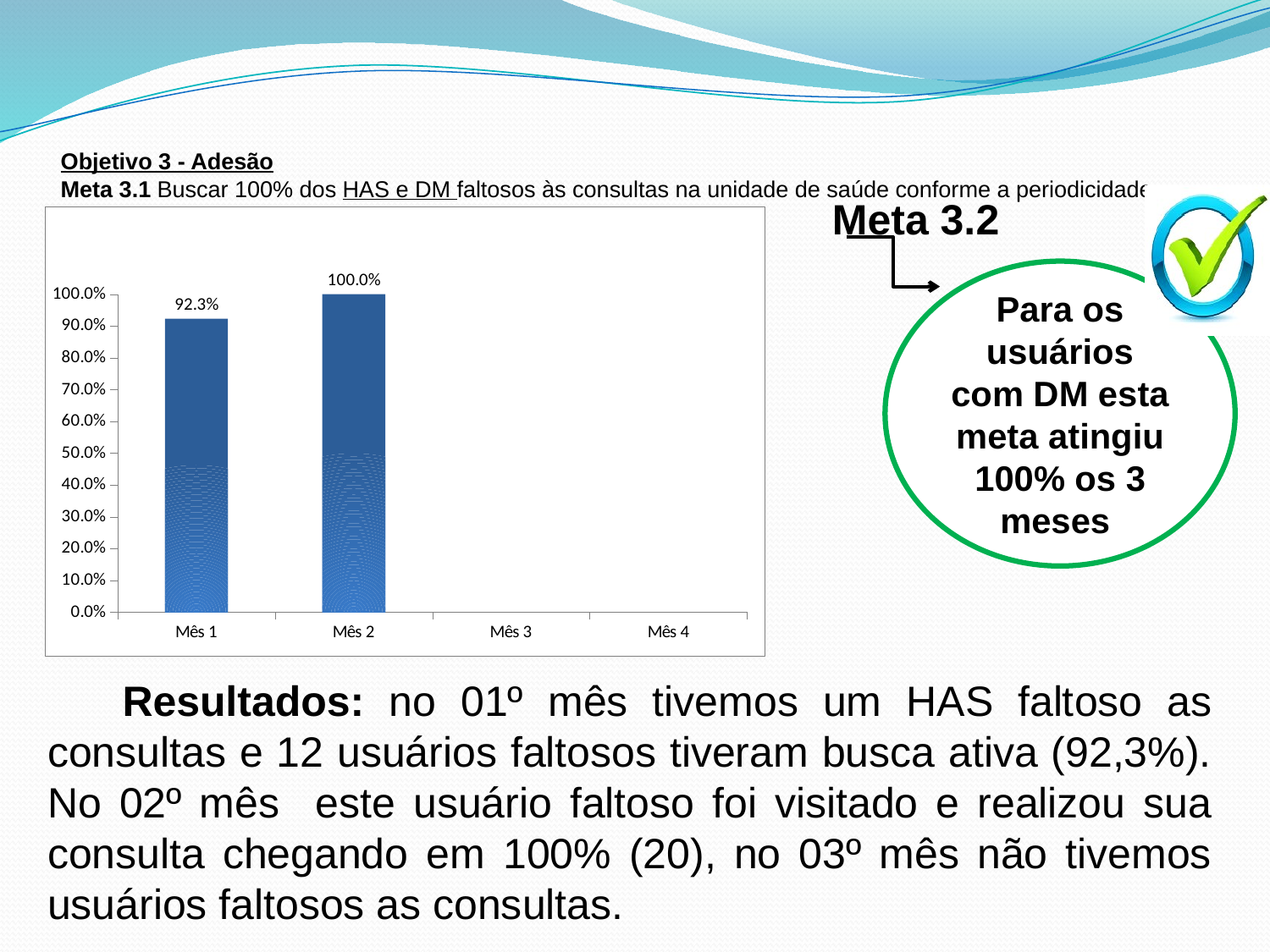
What is the value for Mês 2? 100.0% What is the label of the last category on the x axis? Mês 4 Is the value for Mês 1 greater or less than 90.0%? greater How many bars are actually plotted in the chart? 2 What is the highest tick value shown on the y axis? 100.0% How many categories are shown on the x axis of the chart? 4 Does the value rise or fall from Mês 1 to Mês 2? rise What is the difference between the values for Mês 2 and Mês 1? 7.7% What is the value for Mês 1? 92.3% Which month has the highest value in the chart? Mês 2 What kind of chart is shown on the slide? bar chart Which of the two plotted bars is larger, Mês 1 or Mês 2? Mês 2